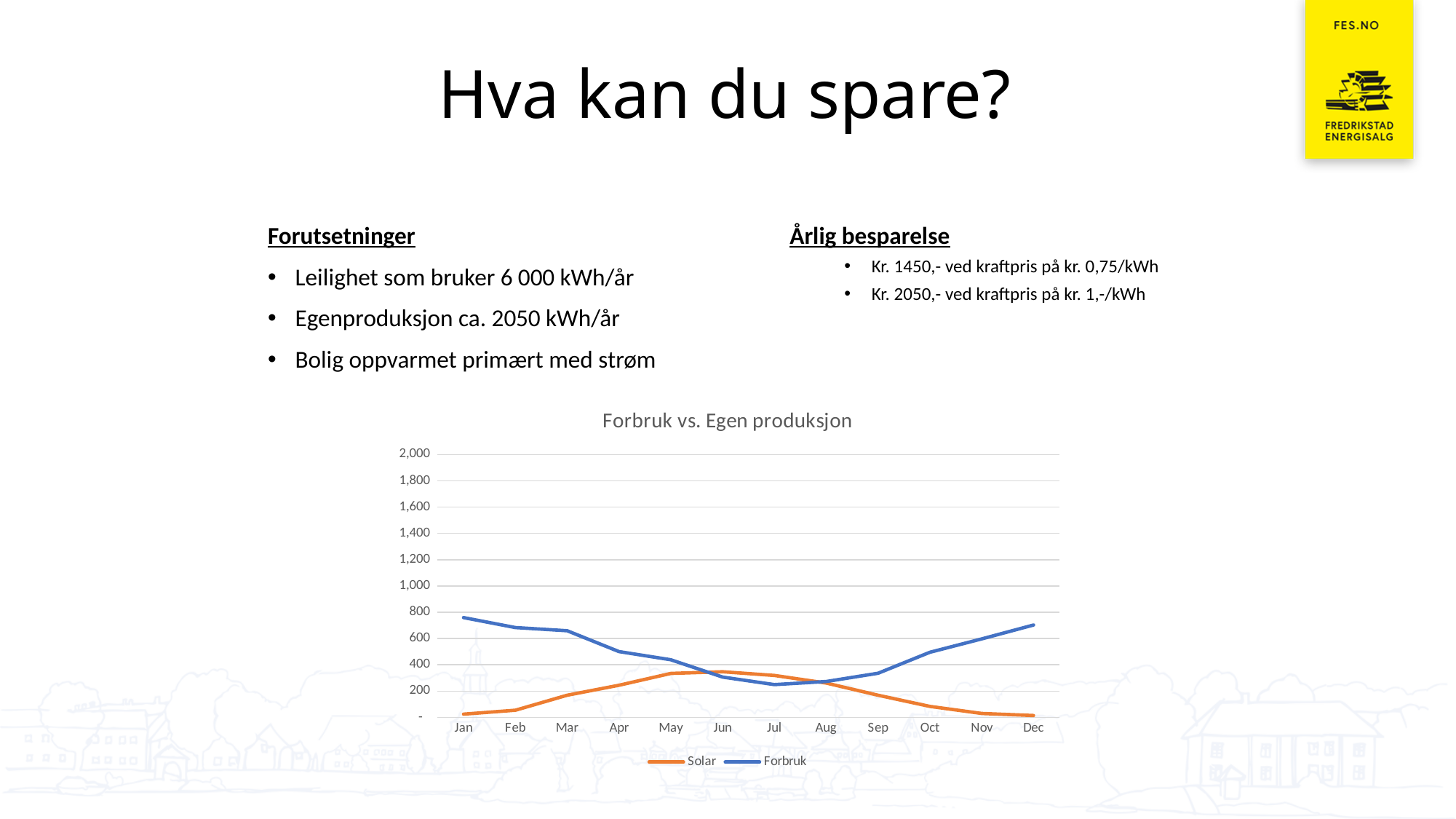
In Jul, which series has the larger value, Solar or Forbruk? Solar What kind of chart is shown on the slide? line chart In Jan, which series has the larger value, Solar or Forbruk? Forbruk Which colour is used for the Solar series in the chart? orange How many series does the chart legend list? 2 Does the Forbruk series rise or fall from Jan to Jul? fall What is the title of the chart? Forbruk vs. Egen produksjon Is the Forbruk value for Jul greater or less than 400? less Is the Forbruk value for Jan greater or less than 600? greater How many months are plotted along the x axis of the chart? 12 Is the Solar value for Jan greater or less than 200? less In which month does the Solar series reach its highest value? Jun